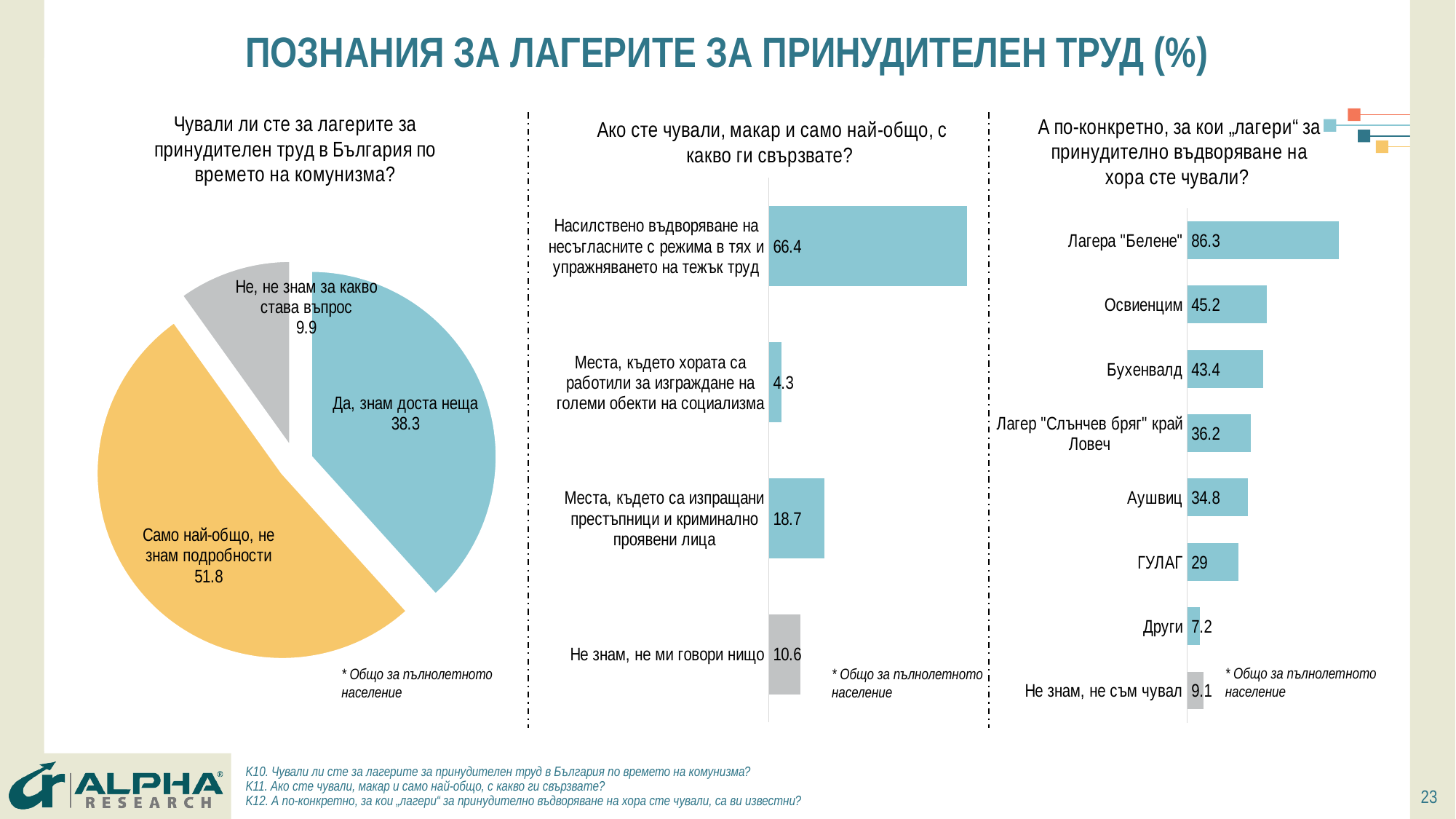
In the left pie chart, which category has the smallest slice? Не, не знам за какво става въпрос How many categories are shown in the right bar chart? 8 In the middle bar chart, which category has the lowest value? Места, където хората са работили за изграждане на големи обекти на социализма In the left pie chart, what is the difference between "Само най-общо, не знам подробности" and "Да, знам доста неща"? 13.5 In the right bar chart, what is the value for "Бухенвалд"? 43.4 In the right bar chart, which category has the highest value? Лагера "Белене" In the left pie chart, what is the value for "Само най-общо, не знам подробности"? 51.8 What type of chart is the left chart on the slide? Pie chart In the right bar chart, what is the difference between "Лагера "Белене"" and "Освиенцим"? 41.1 How many categories are shown in the middle bar chart? 4 In the middle bar chart, what is the value for "Места, където са изпращани престъпници и криминално проявени лица"? 18.7 In the right bar chart, which is larger: "ГУЛАГ" or "Аушвиц"? Аушвиц